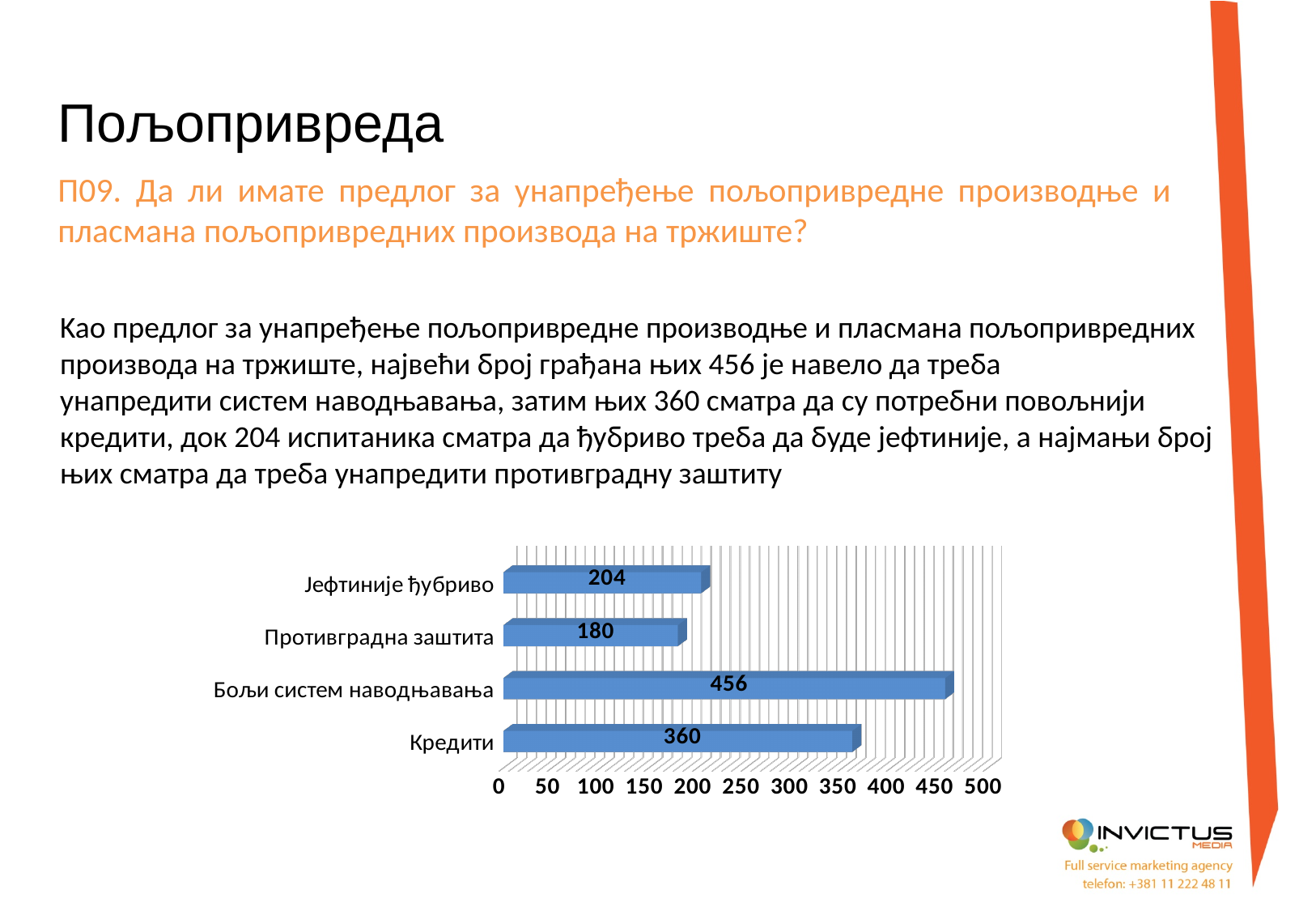
Which category has the highest value? Бољи систем наводњавања What kind of chart is shown on the slide? bar chart What is the value for Јефтиније ђубриво? 204 Which is larger, the value for Кредити or the value for Јефтиније ђубриво? Кредити What is the value for Кредити? 360 What is the difference between the values for Бољи систем наводњавања and Кредити? 96 What is the value for Противградна заштита? 180 What is the value for Бољи систем наводњавања? 456 Is the value for Кредити greater or less than 300? greater Which category has the lowest value? Противградна заштита What is the difference between the values for Јефтиније ђубриво and Противградна заштита? 24 How many categories are shown in the chart? 4